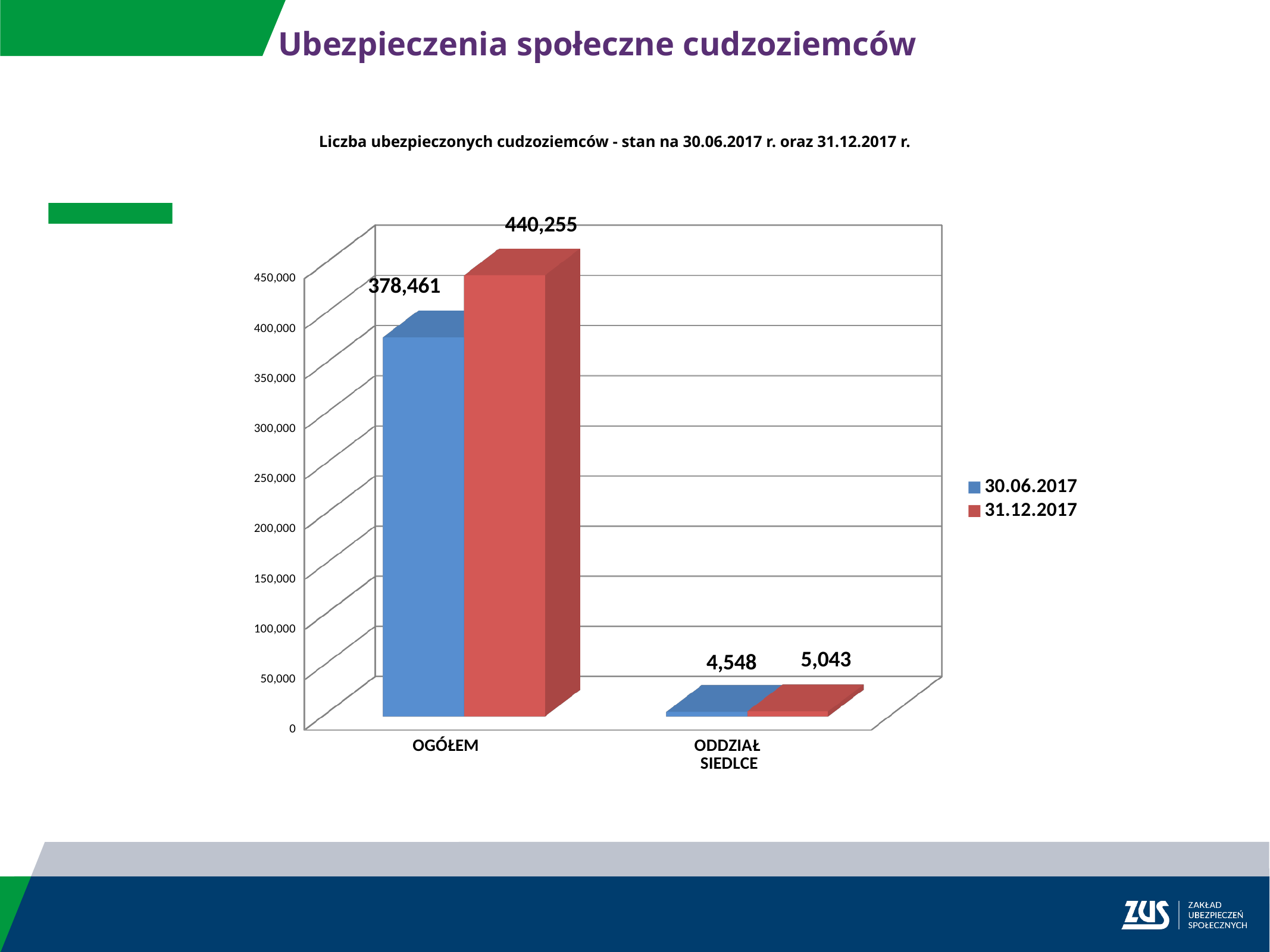
What is the value for ODDZIAŁ SIEDLCE in the 31.12.2017 series? 5,043 What is the value for ODDZIAŁ SIEDLCE in the 30.06.2017 series? 4,548 Which category has the lowest value in the 30.06.2017 series? ODDZIAŁ SIEDLCE How many series does the legend list? 2 What is the value for OGÓŁEM in the 30.06.2017 series? 378,461 For OGÓŁEM, which series has the larger value, 30.06.2017 or 31.12.2017? 31.12.2017 How many categories are shown on the x axis? 2 What is the difference between the 31.12.2017 and 30.06.2017 values for OGÓŁEM? 61,794 Which category has the highest value in the 31.12.2017 series? OGÓŁEM What is the value for OGÓŁEM in the 31.12.2017 series? 440,255 What is the difference between the 31.12.2017 and 30.06.2017 values for ODDZIAŁ SIEDLCE? 495 What kind of chart is shown on the slide? Bar chart